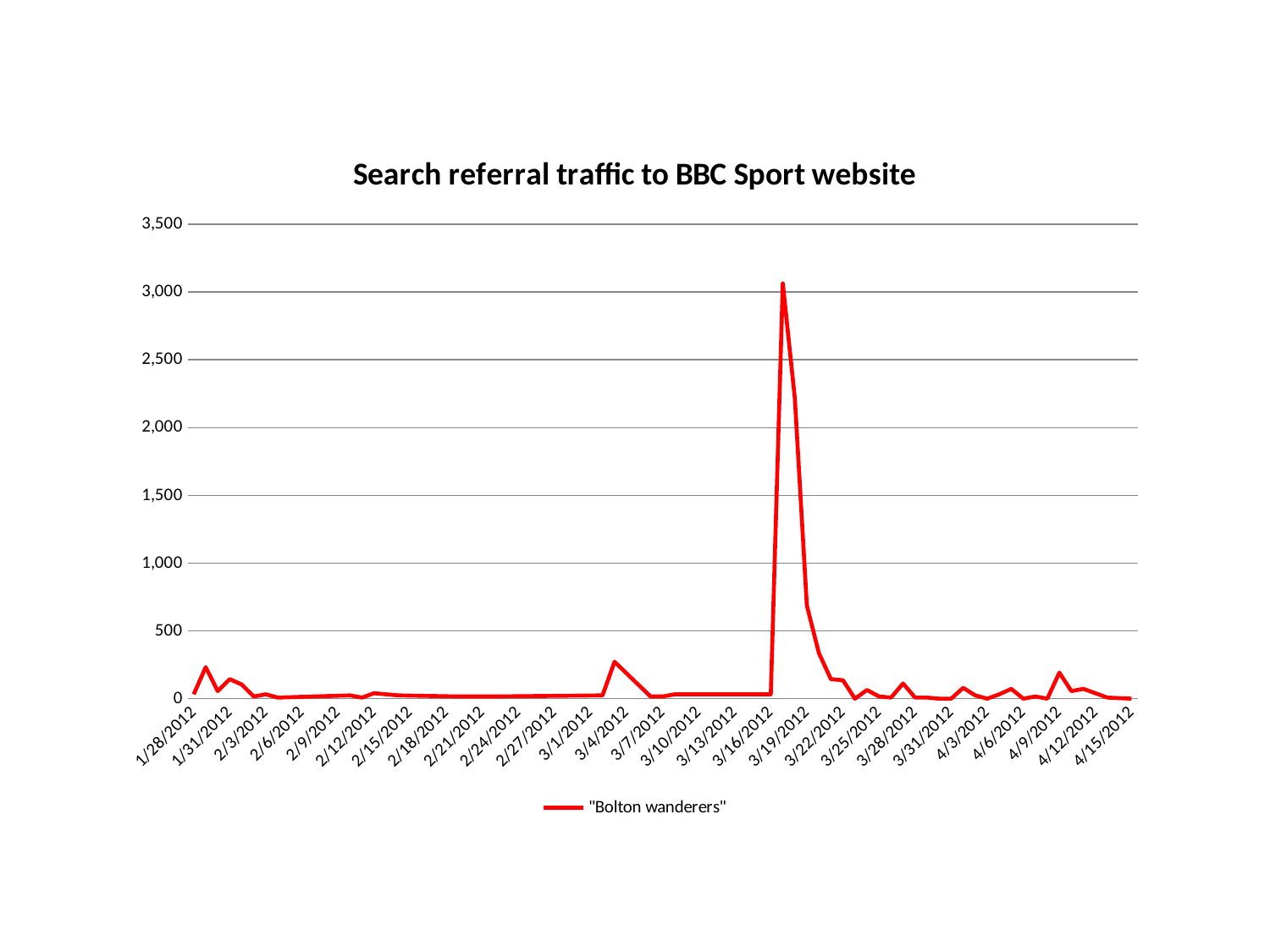
Which has the larger value, 3/4/2012 or 3/7/2012? 3/4/2012 Is the value for 3/4/2012 greater or less than 500? less What kind of chart is shown on the slide? line chart How many date labels are shown on the x axis? 27 Is the value for 2/21/2012 greater or less than 500? less What is the name of the series shown in the legend? "Bolton wanderers" What is the title of the chart? Search referral traffic to BBC Sport website How many series does the legend list? 1 Is the peak value of the line greater or less than 2,500? greater Which has the larger value, 3/4/2012 or 2/21/2012? 3/4/2012